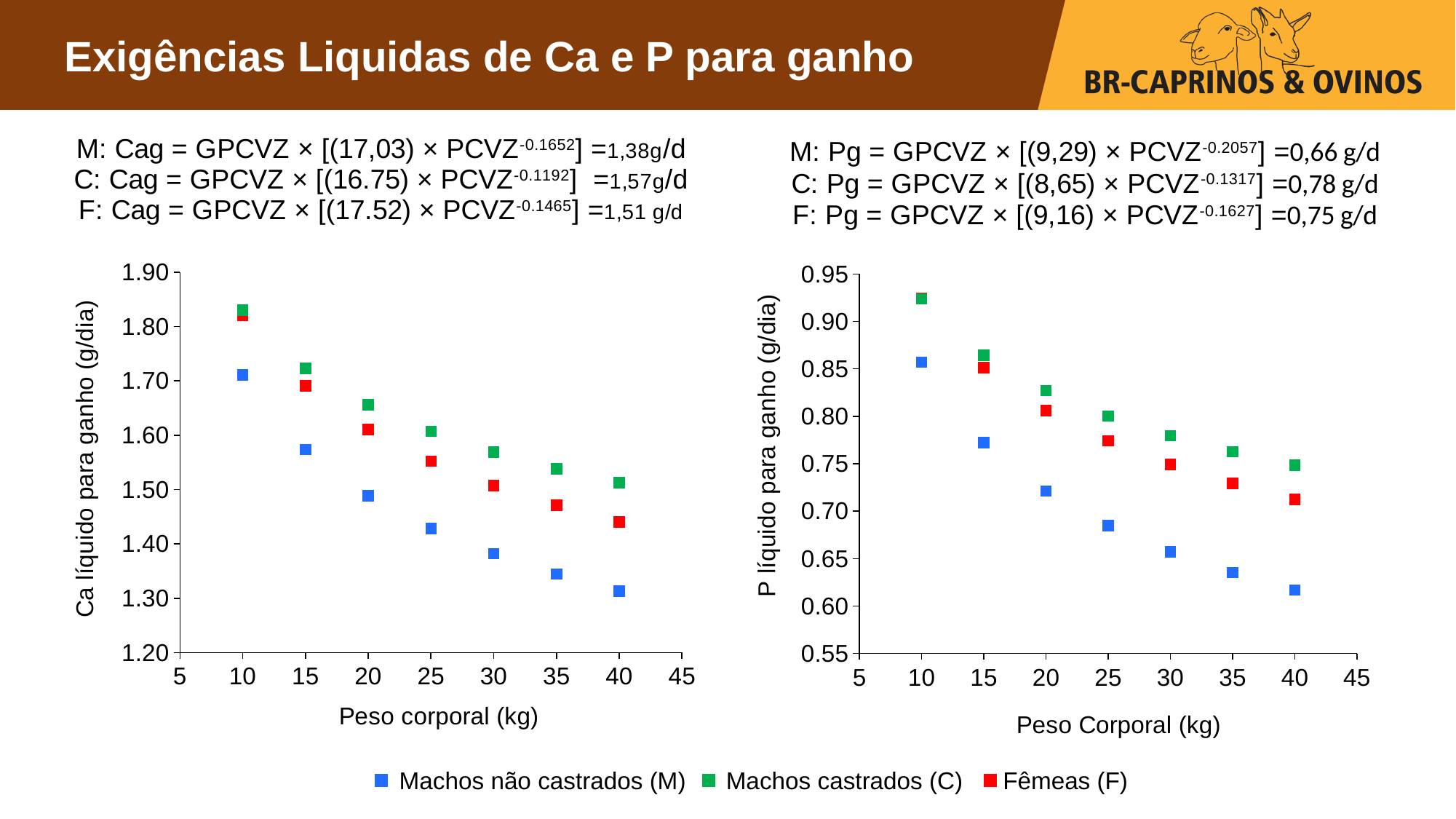
In the right chart (P líquido para ganho), is the value for Machos não castrados (M) at 25 kg greater or less than 0.70? less What kind of chart is the left chart, 'Ca líquido para ganho (g/dia)'? scatter chart What is the x-axis label of the left chart? Peso corporal (kg) In the right chart (P líquido para ganho), which series has the lowest value at 40 kg? Machos não castrados (M) In the right chart (P líquido para ganho), is the value for Machos castrados (C) at 10 kg greater or less than 0.90? greater In the left chart (Ca líquido para ganho), which is larger at 40 kg: Machos castrados (C) or Machos não castrados (M)? Machos castrados (C) In the right chart (P líquido para ganho), do the values for Fêmeas (F) rise or fall as body weight increases? fall In the left chart (Ca líquido para ganho), do the values rise or fall as body weight increases from 10 to 40 kg? fall How many series does the legend list for the charts? 3 In the left chart (Ca líquido para ganho), is the value for Machos castrados (C) at 10 kg greater or less than 1.80? greater In the left chart (Ca líquido para ganho), how many body-weight points are plotted for the Machos castrados (C) series? 7